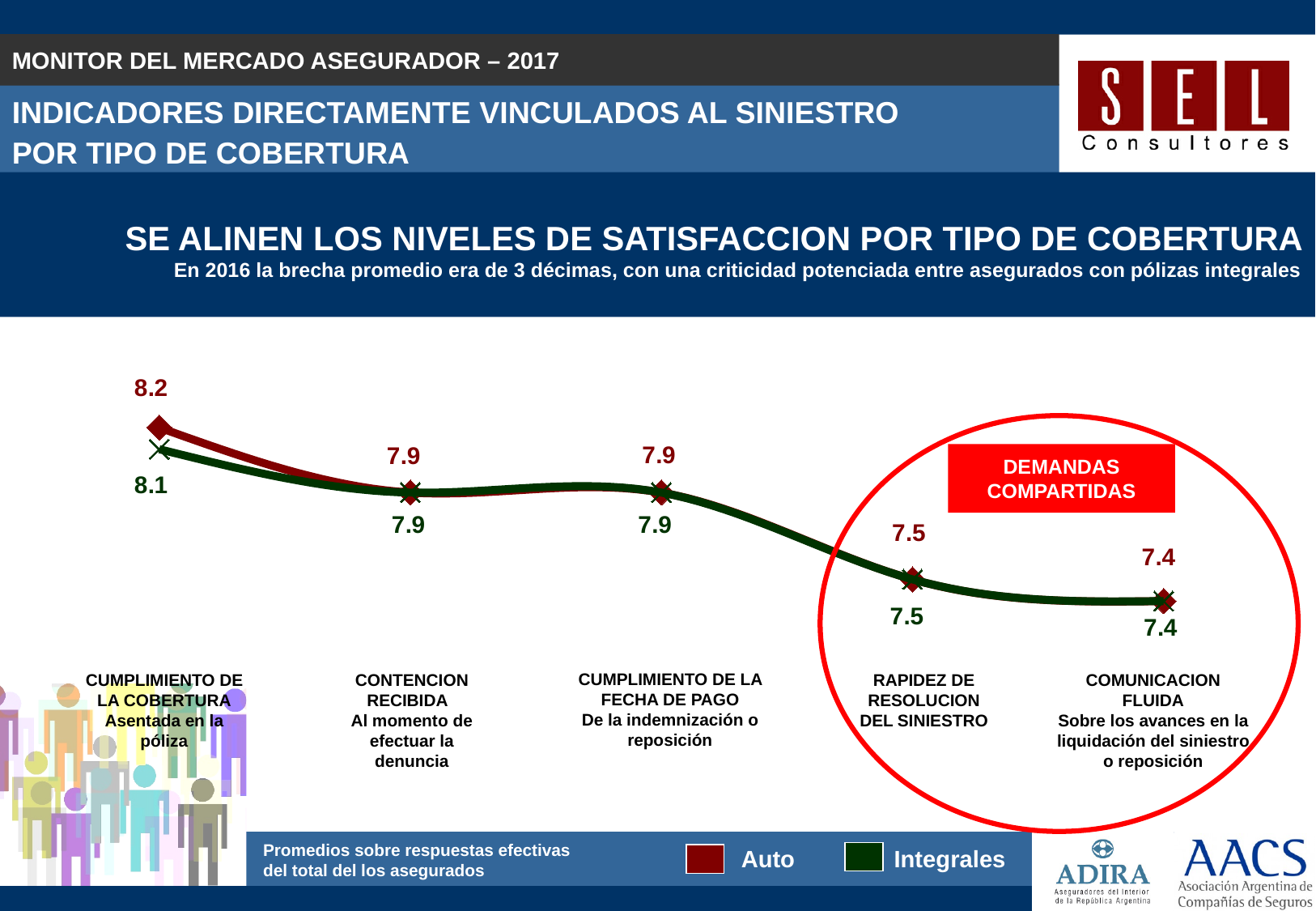
Which category has the lowest Integrales value? COMUNICACION FLUIDA What is the difference between the Auto and Integrales values for CUMPLIMIENTO DE LA COBERTURA? 0.1 How many categories are shown on the x axis of the chart? 5 What is the Integrales value for CUMPLIMIENTO DE LA COBERTURA? 8.1 What is the difference between the Auto value for CUMPLIMIENTO DE LA COBERTURA and the Auto value for COMUNICACION FLUIDA? 0.8 What is the Integrales value for COMUNICACION FLUIDA? 7.4 What is the Auto value for RAPIDEZ DE RESOLUCION DEL SINIESTRO? 7.5 How many series does the legend list? 2 Which category has the highest Auto value? CUMPLIMIENTO DE LA COBERTURA Which is larger for CUMPLIMIENTO DE LA COBERTURA, the Auto value or the Integrales value? Auto What kind of chart is shown on the slide? Line chart What is the Auto value for CUMPLIMIENTO DE LA COBERTURA? 8.2